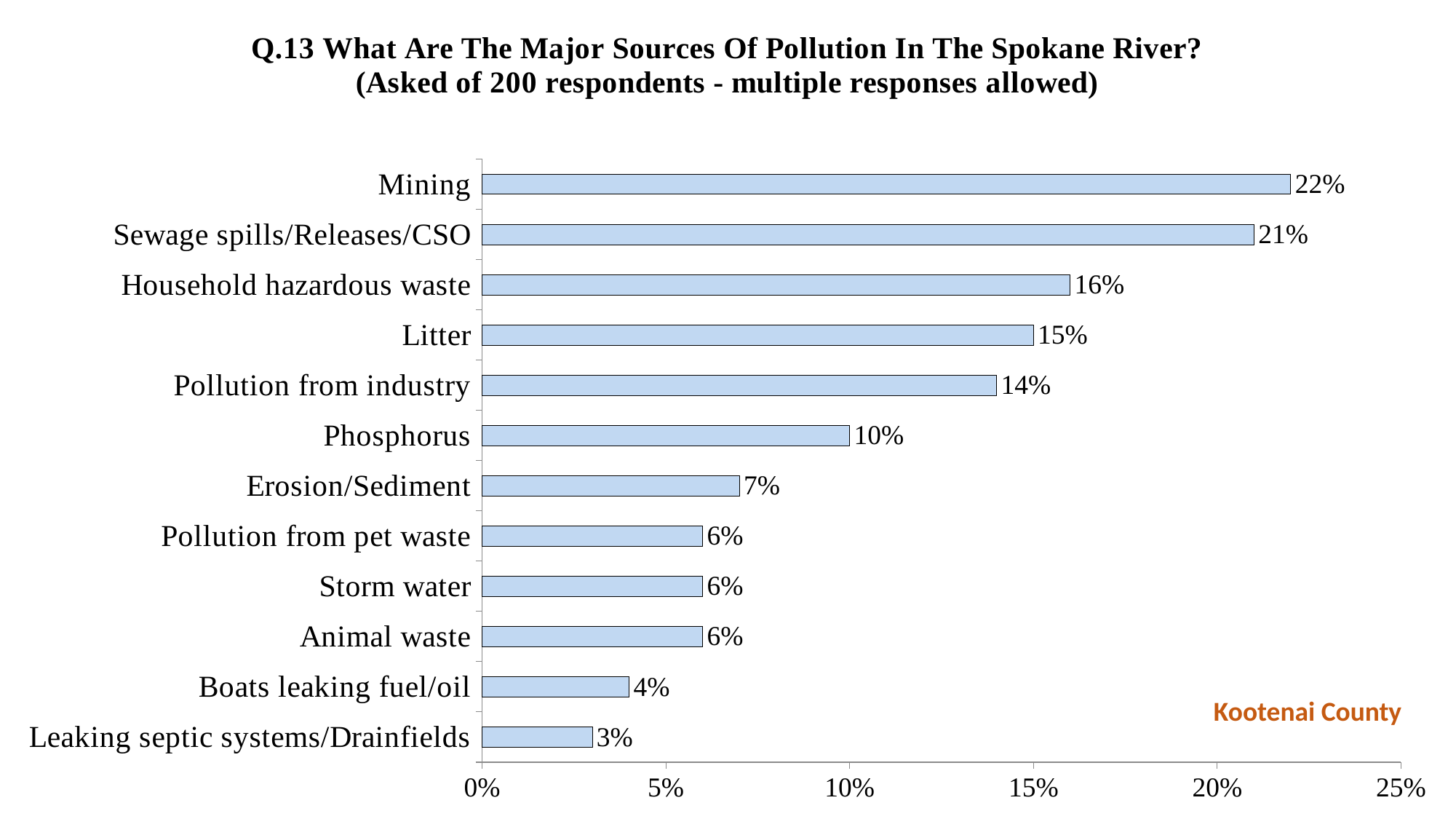
Which category has the lowest value? Leaking septic systems/Drainfields What is the value for Boats leaking fuel/oil? 4% What is the difference between Household hazardous waste and Erosion/Sediment? 9% What is the difference between the values for Mining and Litter? 7% Is the value for Household hazardous waste greater or less than 15%? greater Which category has the highest value? Mining How many respondents were asked the question, according to the chart title? 200 What is the value for Phosphorus? 10% How many categories are shown in the chart? 12 What kind of chart is shown on the slide? Bar chart What percentage of respondents named Mining as a major source of pollution? 22% Which is larger, the value for Sewage spills/Releases/CSO or the value for Pollution from industry? Sewage spills/Releases/CSO